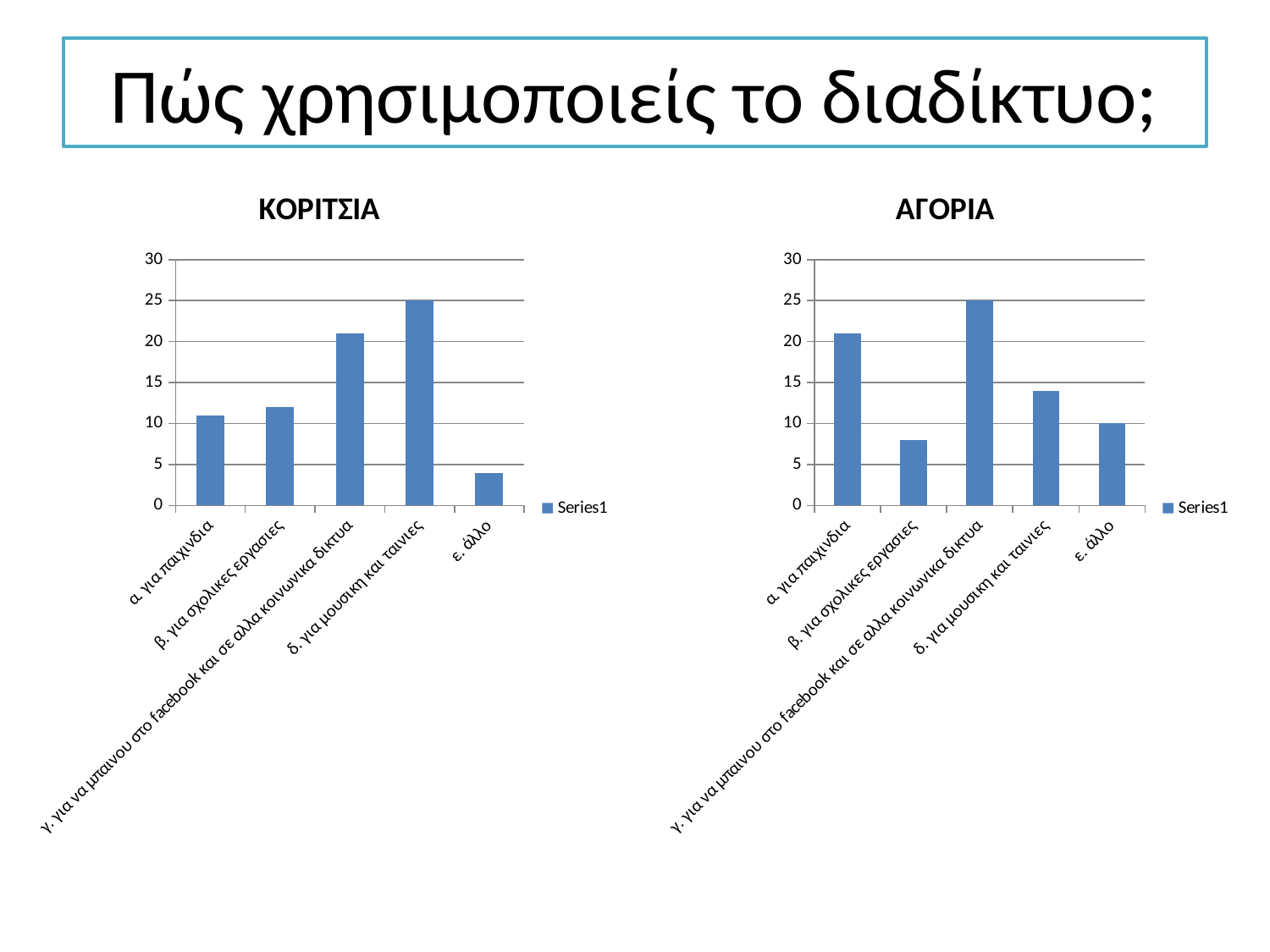
In the ΑΓΟΡΙΑ chart, what is the value for ε. άλλο? 10 In the ΚΟΡΙΤΣΙΑ chart, what is the value for δ. για μουσικη και ταινιες? 25 In the ΑΓΟΡΙΑ chart, what is the value for γ. για να μπαινου στο facebook και σε αλλα κοινωνικα δικτυα? 25 In the ΚΟΡΙΤΣΙΑ chart, which category has the lowest value? ε. άλλο In the ΑΓΟΡΙΑ chart, which category has the lowest value? β. για σχολικες εργασιες In the ΚΟΡΙΤΣΙΑ chart, which is larger: the value for α. για παιχνιδια or the value for δ. για μουσικη και ταινιες? δ. για μουσικη και ταινιες What kind of chart is the ΚΟΡΙΤΣΙΑ chart? bar chart In the ΚΟΡΙΤΣΙΑ chart, is the value for γ. για να μπαινου στο facebook και σε αλλα κοινωνικα δικτυα greater or less than 20? greater In the ΚΟΡΙΤΣΙΑ chart, which category has the highest value? δ. για μουσικη και ταινιες How many categories are shown in the ΑΓΟΡΙΑ chart? 5 In the ΑΓΟΡΙΑ chart, which category has the highest value? γ. για να μπαινου στο facebook και σε αλλα κοινωνικα δικτυα In the ΑΓΟΡΙΑ chart, is the value for δ. για μουσικη και ταινιες greater or less than 15? less